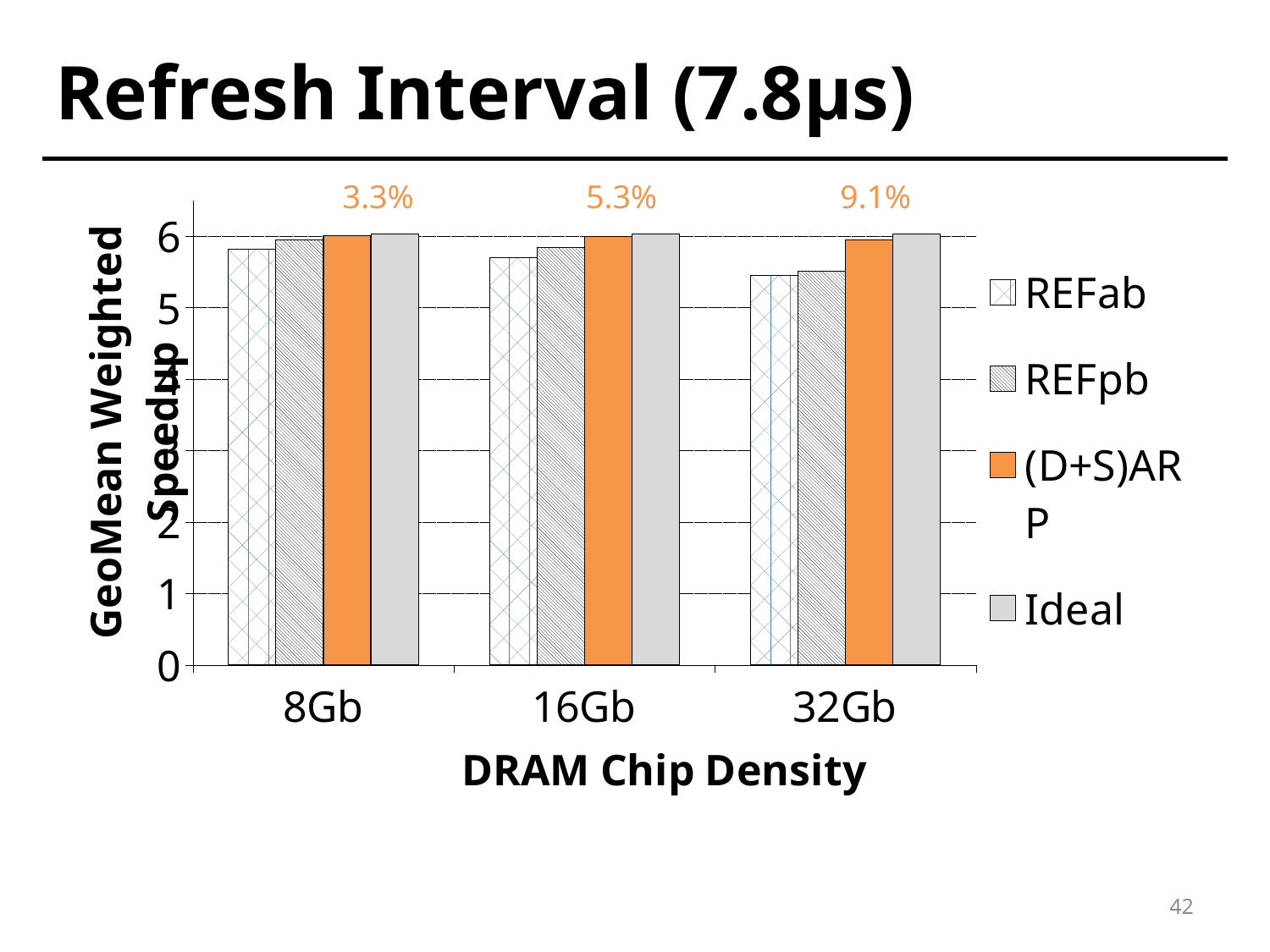
How many series does the legend list? 4 Is the REFab value at 32Gb greater or less than 6? less Is the REFab value at 32Gb greater or less than 5? greater Do the REFab values rise or fall as DRAM chip density increases from 8Gb to 32Gb? fall At 32Gb, which is larger, the REFab bar or the Ideal bar? Ideal What percentage is printed above the 16Gb group of bars? 5.3% What percentage is printed above the 32Gb group of bars? 9.1% What percentage is printed above the 8Gb group of bars? 3.3% How many DRAM chip density categories are shown on the x axis? 3 What kind of chart is shown on the slide? bar chart What is the title of the x axis? DRAM Chip Density At 32Gb, which series has the lowest bar? REFab